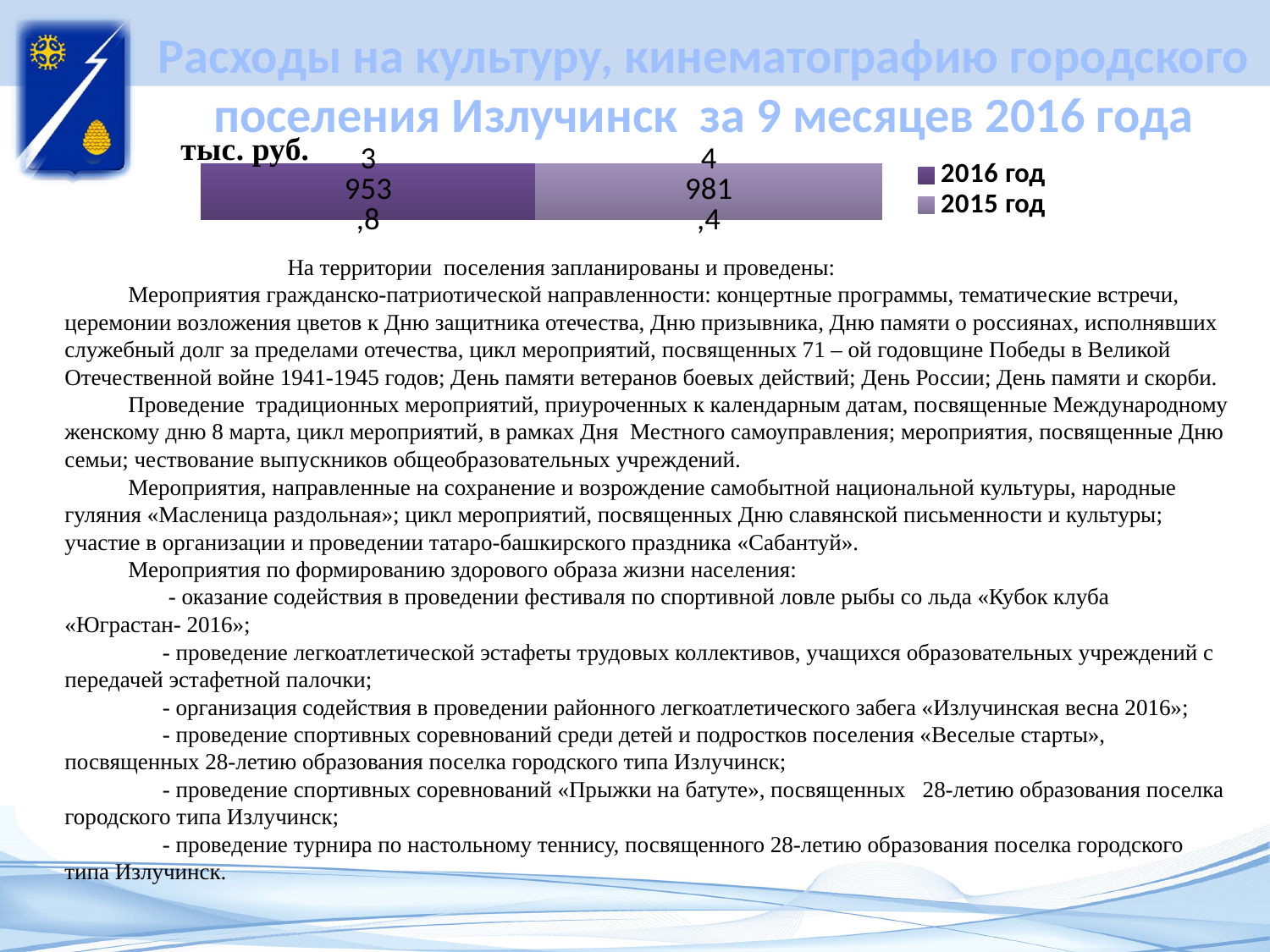
Which series has the lowest value on the chart? 2016 год Which series is shown in the darker purple colour? 2016 год What is the value for 2015 год on the chart? 4 981,4 What is the value for 2016 год on the chart? 3 953,8 How many series does the legend list? 2 What is the total of the two segments in the stacked bar? 8 935,2 What kind of chart is shown on the slide? Bar chart Which year has the larger value, 2016 год or 2015 год? 2015 год What is the difference between the values for 2015 год and 2016 год? 1 027,6 What unit is indicated for the chart values? тыс. руб. Which series has the highest value on the chart? 2015 год